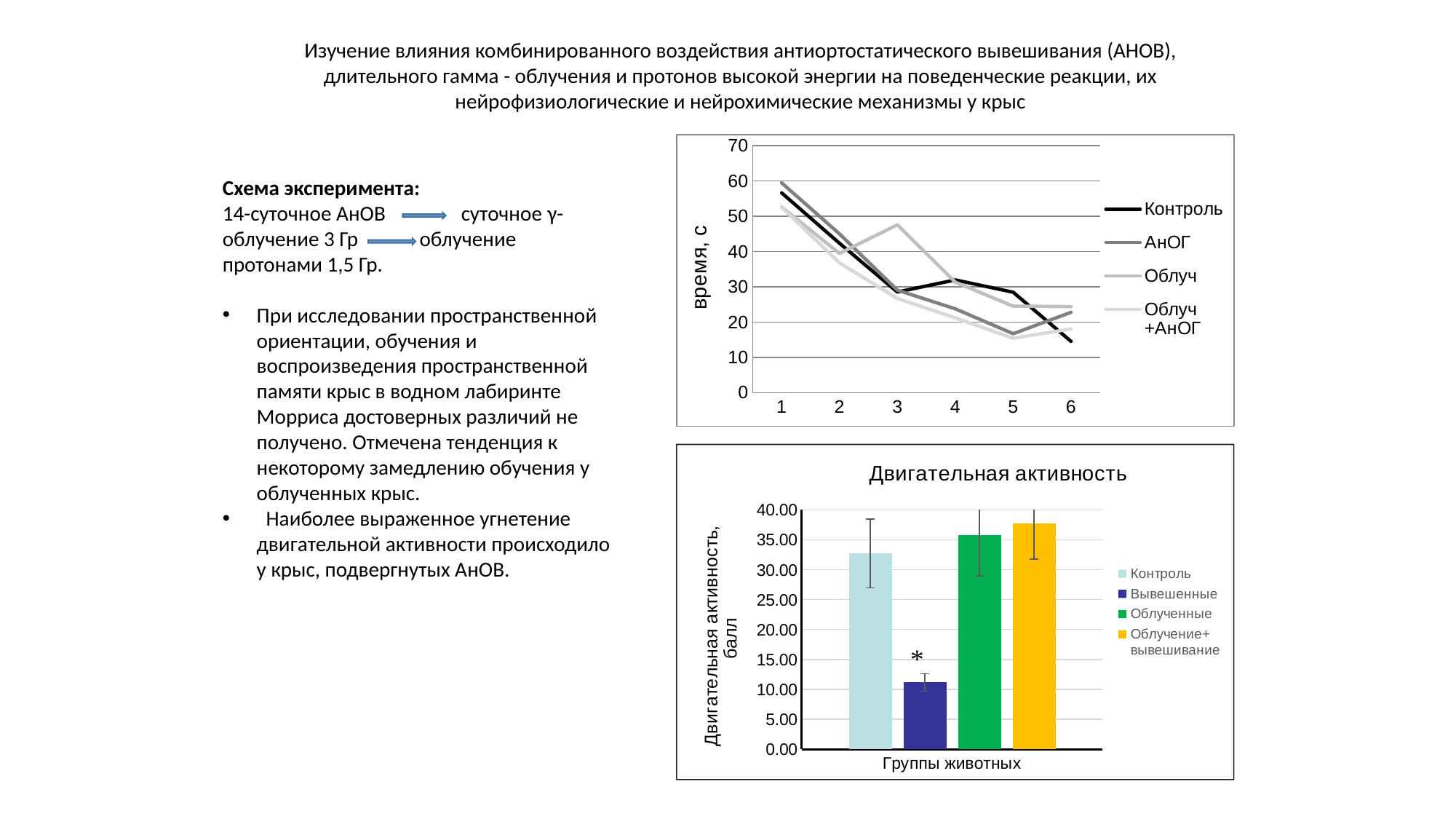
In the chart 'Двигательная активность', is the value for 'Контроль' greater or less than 30.00? greater How many points are plotted along the x axis of the top line chart? 6 In the top line chart, is the value of 'Контроль' larger at point 1 or at point 6? point 1 How many series does the legend of the chart 'Двигательная активность' list? 4 In the top line chart, is the value of 'Контроль' at point 1 greater or less than 50? greater In the top line chart, do the values of the 'Контроль' series generally rise or fall from point 1 to point 6? fall In the chart 'Двигательная активность', is the value for 'Вывешенные' greater or less than 15.00? less How many series does the legend of the top line chart list? 4 In the chart 'Двигательная активность', which group has the lowest value? Вывешенные What kind of chart is the chart titled 'Двигательная активность'? bar chart What kind of chart is the top chart on the slide? line chart In the top line chart, which series has the highest value at point 3? Облуч